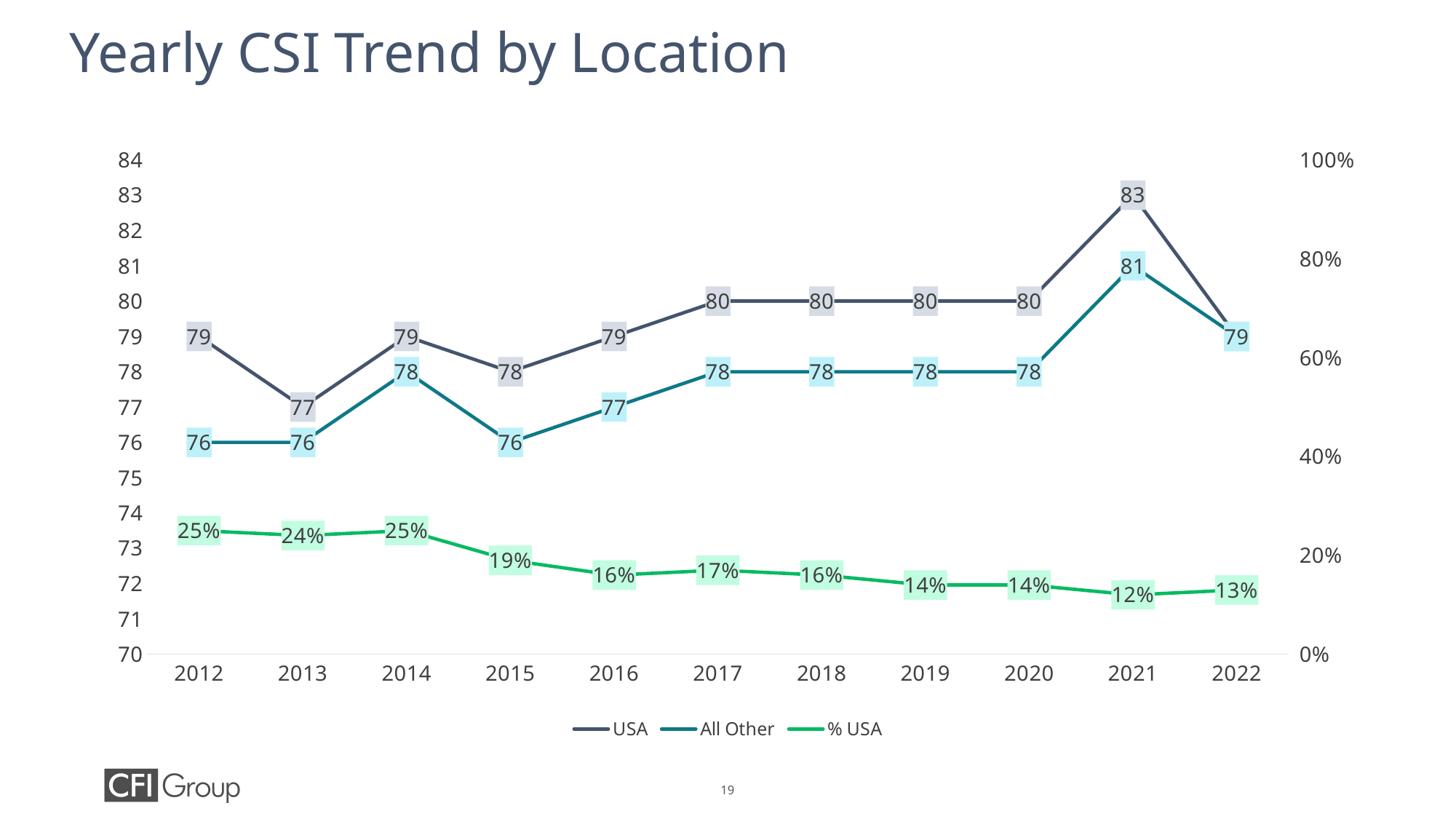
Which is larger in 2022, the USA CSI value or the All Other CSI value? They are equal (79) How many years are shown on the x axis? 11 What is the USA CSI value for 2021? 83 What is the All Other CSI value for 2016? 77 How many series does the legend list? 3 In which year is the USA CSI highest? 2021 What is the title of the chart? Yearly CSI Trend by Location What is the % USA value for 2015? 19% In which year is the % USA value lowest? 2021 What kind of chart is shown on the slide? Line chart Does the % USA series generally rise or fall from 2012 to 2022? Fall What is the difference between the USA and All Other CSI values in 2013? 1